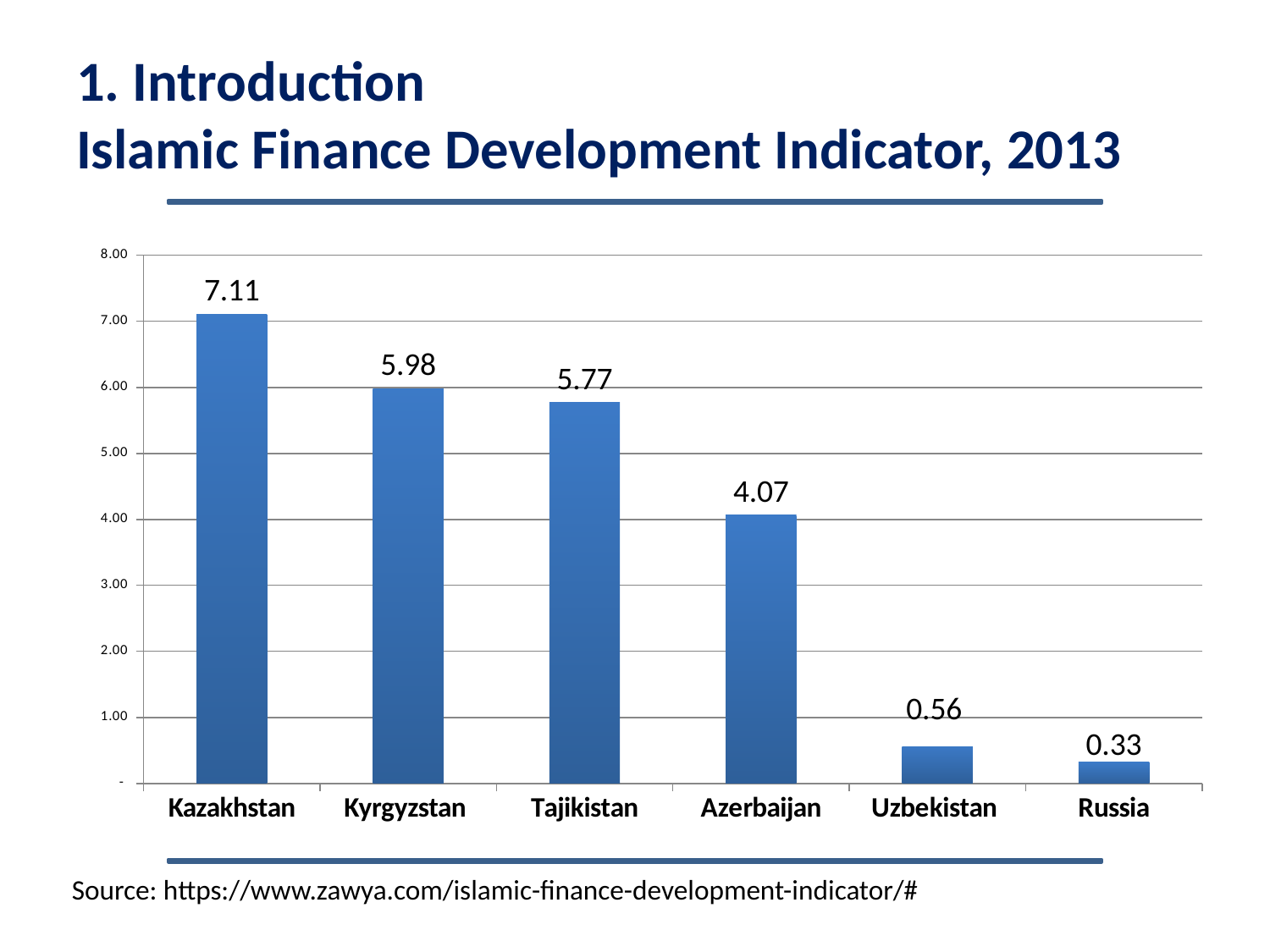
What is the value shown for Russia? 0.33 What is the Islamic Finance Development Indicator value for Kazakhstan? 7.11 What is the value shown for Azerbaijan? 4.07 How many countries are shown on the chart? 6 What is the difference between the values for Uzbekistan and Russia? 0.23 What is the difference between the values for Kazakhstan and Kyrgyzstan? 1.13 What kind of chart is shown on the slide? Bar chart Is the value for Kyrgyzstan greater or less than 5.00? greater Which has a larger value, Tajikistan or Azerbaijan? Tajikistan Do the values rise or fall from left to right across the countries? Fall Which country has the lowest value on the chart? Russia Which country has the highest value on the chart? Kazakhstan